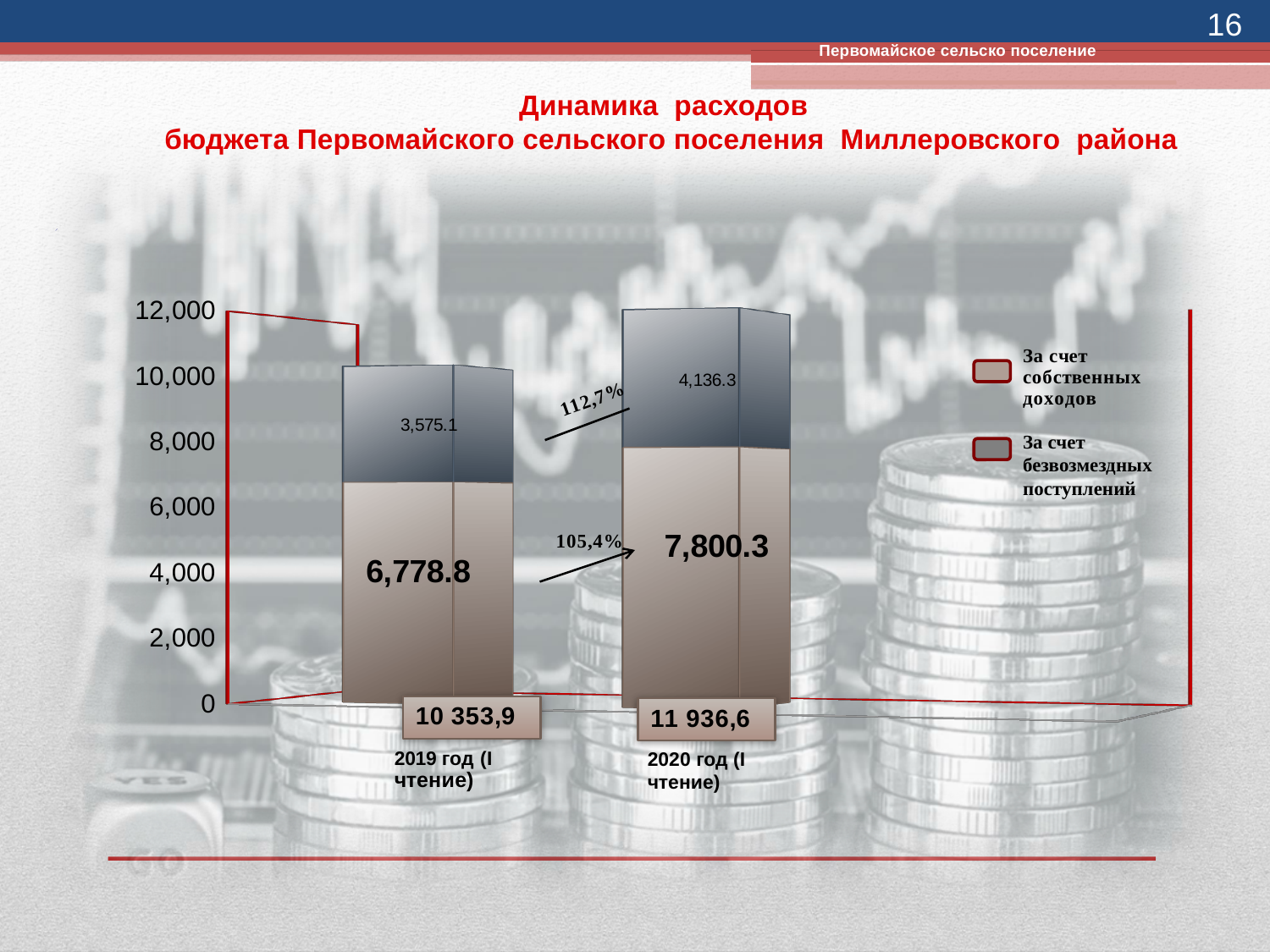
What is the value of the bottom segment of the bar for 2019 год (I чтение)? 6,778.8 How many categories (years) are plotted on the chart? 2 What is the difference between the bottom segment values for 2020 год (I чтение) and 2019 год (I чтение)? 1,021.5 What type of chart is shown on the slide? Stacked bar chart How many series does the legend list? 2 What is the value of the top segment of the bar for 2019 год (I чтение)? 3,575.1 Is the total for 2019 год (I чтение) greater or less than 10,000? greater Which year has the higher total expenditure, 2019 год (I чтение) or 2020 год (I чтение)? 2020 год (I чтение) What total is shown for the bar for 2020 год (I чтение)? 11 936,6 What percentage growth label is shown next to the top segment between 2019 and 2020? 112,7% What total is shown for the bar for 2019 год (I чтение)? 10 353,9 What is the value of the top segment of the bar for 2020 год (I чтение)? 4,136.3